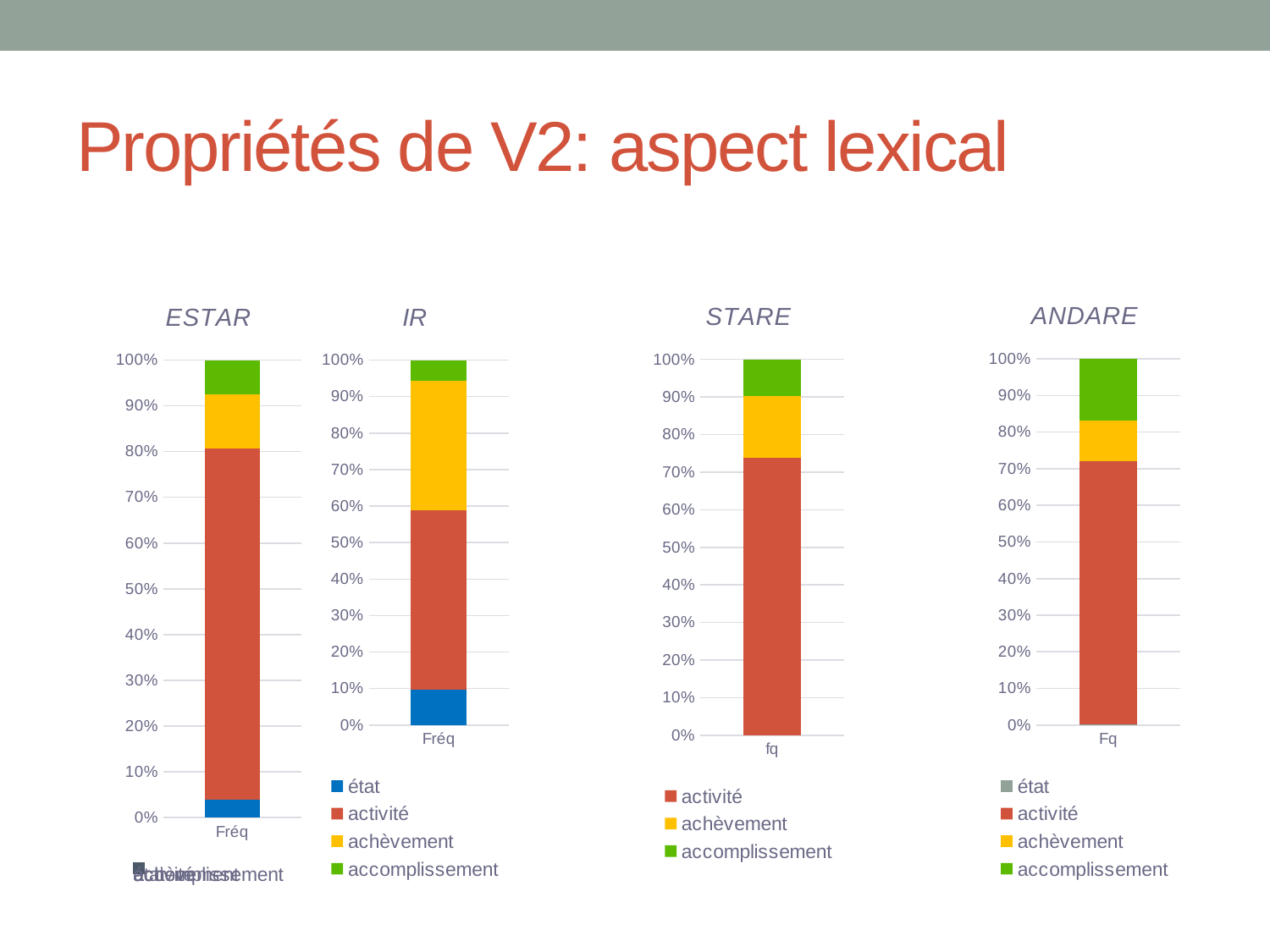
In the IR chart, which segment is larger, activité or accomplissement? activité In the ESTAR chart, is the top of the activité segment greater or less than 70%? greater What is the x-axis category label of the STARE chart? fq In the STARE chart, which series occupies the largest portion of the bar? activité In the IR chart, is the top of the état segment greater or less than 20%? less How many series does the legend of the STARE chart list? 3 What kind of chart is the STARE chart? stacked bar chart How many bars are plotted in the ANDARE chart? 1 In the STARE chart, is the top of the activité segment greater or less than 80%? less How many series does the legend of the IR chart list? 4